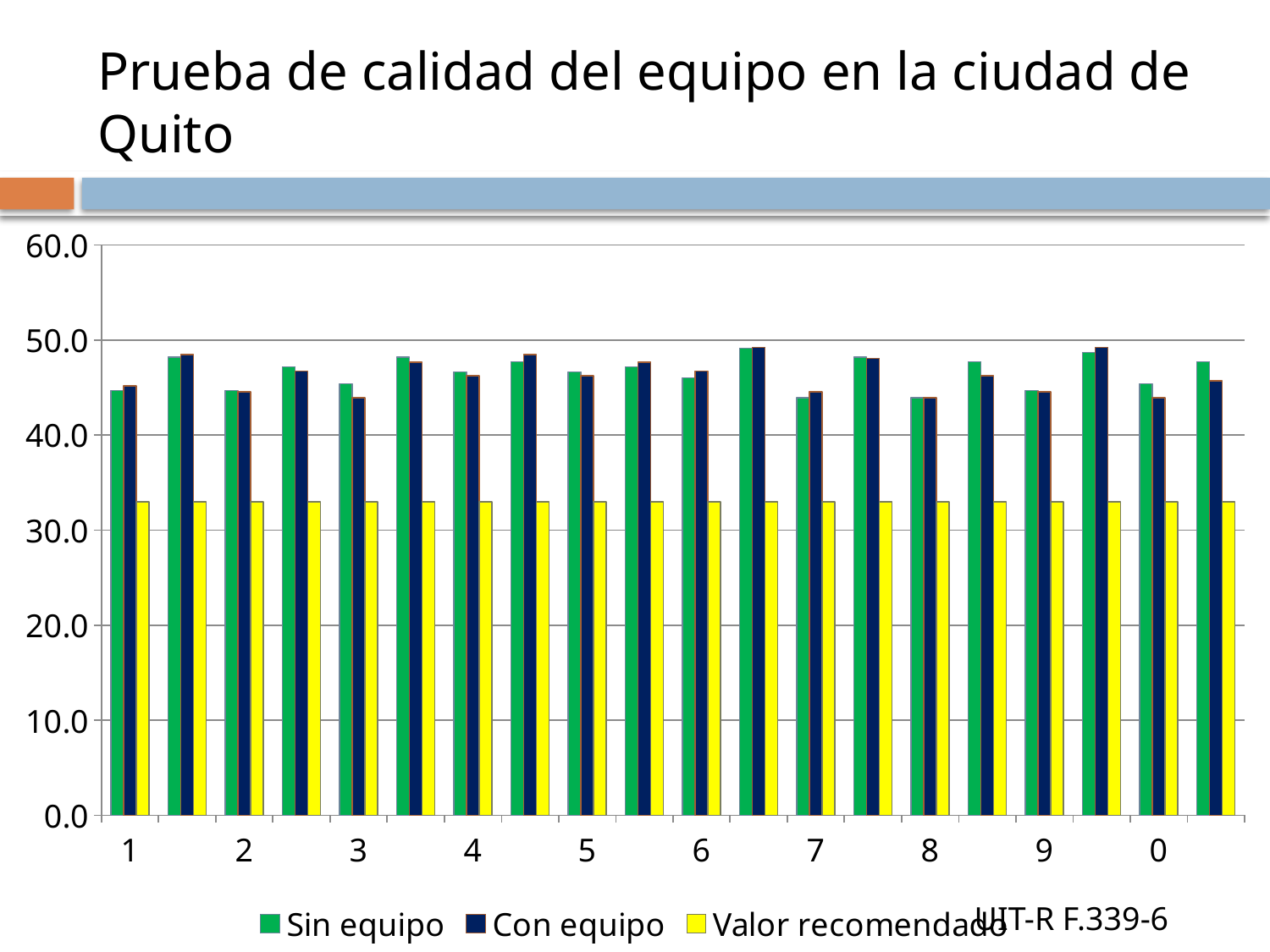
Is the value for Valor recomendado at category 5 greater or less than 30? greater What kind of chart is shown on the slide? Bar chart Which series is shown in yellow in the legend? Valor recomendado At category 3, which is larger: Sin equipo or Con equipo? Sin equipo Is the value for Sin equipo at category 1 greater or less than 40? greater What is the title of the slide containing the chart? Prueba de calidad del equipo en la ciudad de Quito Is the value for Con equipo at category 1 greater or less than 50? less How many series does the legend list? 3 Do the values for Valor recomendado rise, fall, or stay constant across the x axis? Stay constant Which series has the lowest value at category 1? Valor recomendado At category 1, which is larger: Sin equipo or Valor recomendado? Sin equipo